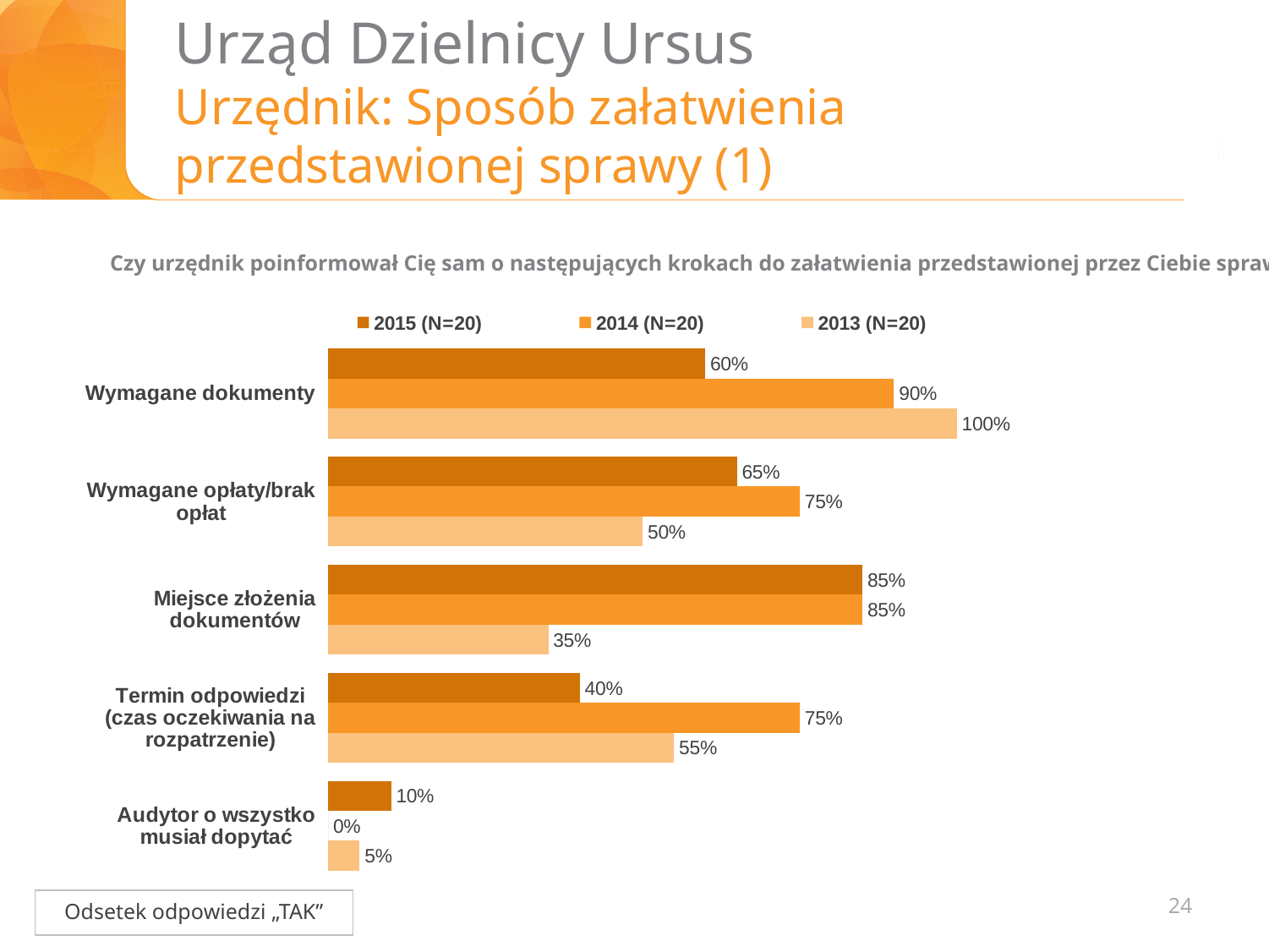
What is the value for Audytor o wszystko musiał dopytać in the 2014 (N=20) series? 0% What is the value for Wymagane dokumenty in the 2013 (N=20) series? 100% How many categories are shown on the chart? 5 Which category has the highest value in the 2015 (N=20) series? Miejsce złożenia dokumentów Which is larger for Wymagane opłaty/brak opłat: the 2014 (N=20) value or the 2013 (N=20) value? 2014 (N=20) What is the value for Wymagane dokumenty in the 2015 (N=20) series? 60% What is the value for Miejsce złożenia dokumentów in the 2013 (N=20) series? 35% How many series does the legend list? 3 What kind of chart is shown on the slide? Bar chart What is the difference between the 2014 (N=20) and 2015 (N=20) values for Termin odpowiedzi (czas oczekiwania na rozpatrzenie)? 35% What does the box at the bottom left of the chart say the values represent? Odsetek odpowiedzi „TAK” Which category has the lowest value in the 2013 (N=20) series? Audytor o wszystko musiał dopytać